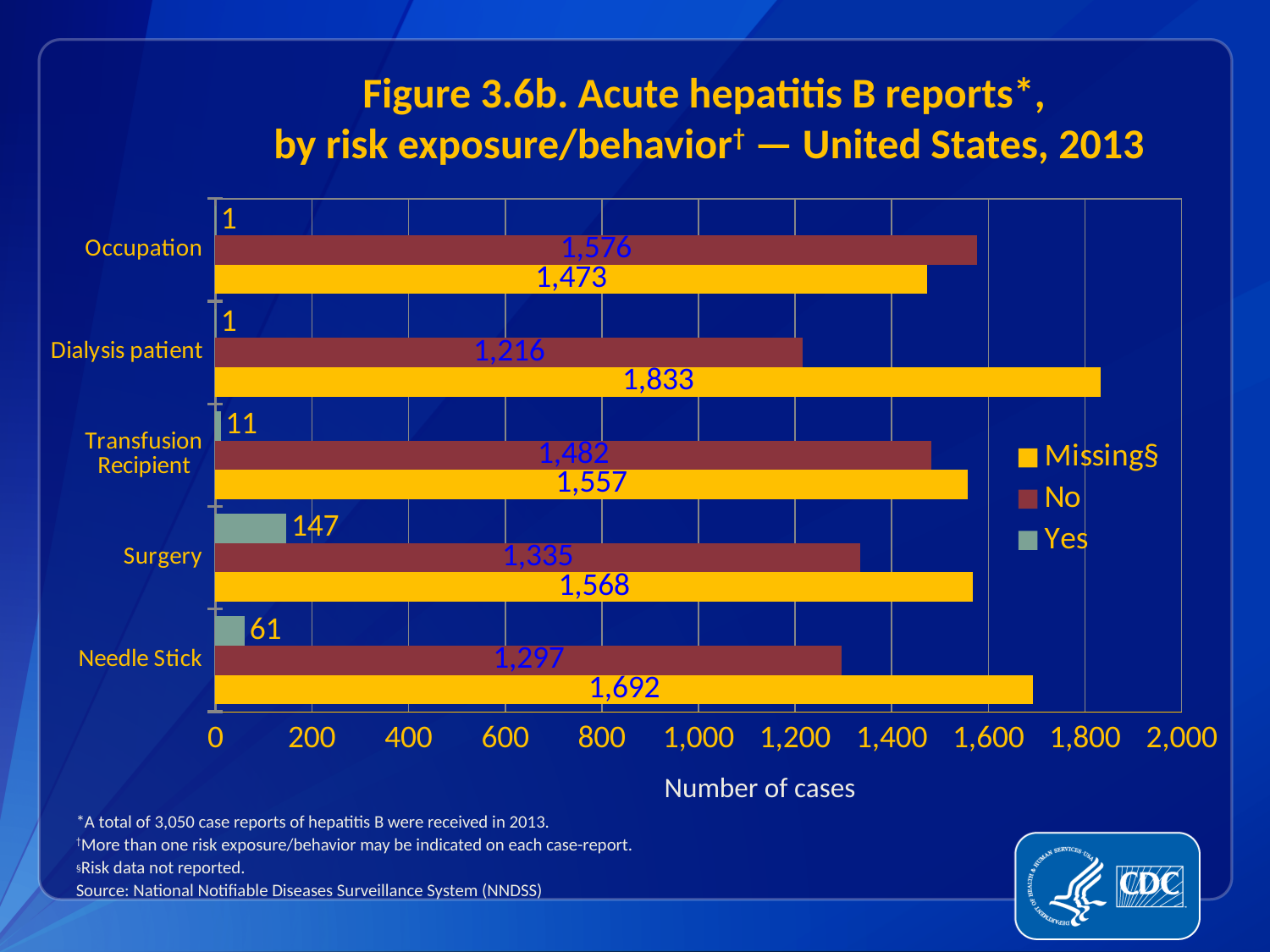
How many series does the legend list? 3 Which category has the highest value in the 'Yes' series? Surgery Which category has the highest value in the 'Missing§' series? Dialysis patient What is the number of cases in the 'Missing§' series for Needle Stick? 1,692 What is the difference between the 'Missing§' and 'No' values for Needle Stick? 395 What is the number of cases in the 'No' series for Dialysis patient? 1,216 How many risk exposure/behavior categories are shown on the chart? 5 What is the number of cases in the 'Yes' series for Surgery? 147 Which category has the lowest value in the 'No' series? Dialysis patient What kind of chart is shown on the slide? Bar chart What is the label of the x axis? Number of cases Which is larger for Occupation: the 'No' value or the 'Missing§' value? No